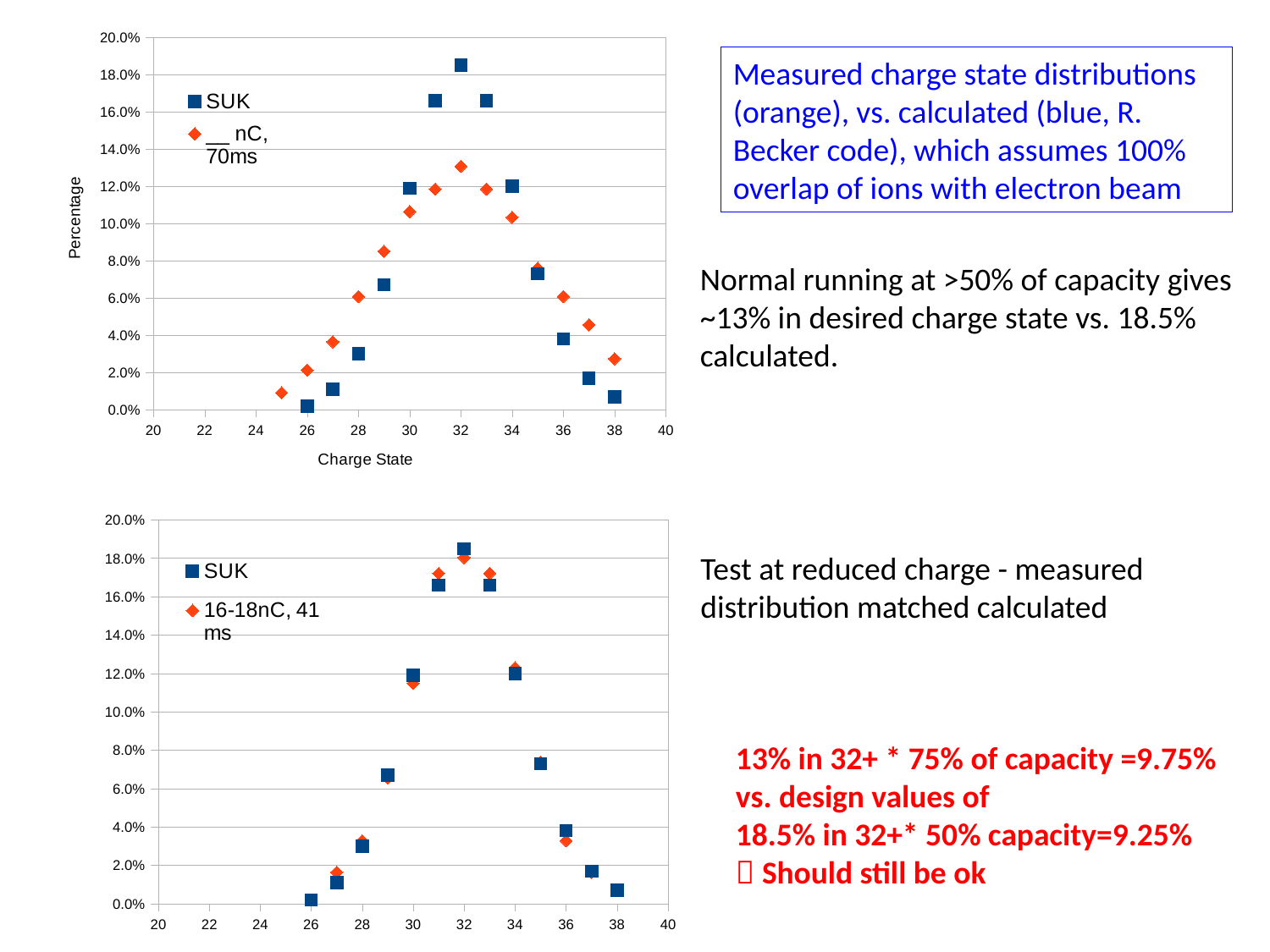
In the top chart, is the orange (nC, 70ms) value at charge state 32 greater or less than 14.0%? less How many series does the legend of the bottom chart list? 2 What is the label of the y axis of the top chart? Percentage In the top chart, at charge state 28, which series has the larger value, SUK or the orange nC, 70ms series? nC, 70ms In the top chart, at which charge state is the SUK series lowest? 26 In the bottom chart, is the orange (16-18nC, 41 ms) value at charge state 36 greater or less than 4.0%? less In the top chart, at charge state 32, which series has the larger value, SUK or the orange nC, 70ms series? SUK In the top chart, at which charge state does the SUK series reach its highest value? 32 What kind of chart is the top chart on the slide? scatter chart In the top chart, is the SUK value at charge state 32 greater or less than 16.0%? greater In the top chart, how do the SUK values change as the charge state increases from 26 to 32? they rise How many SUK data points are plotted in the top chart? 13